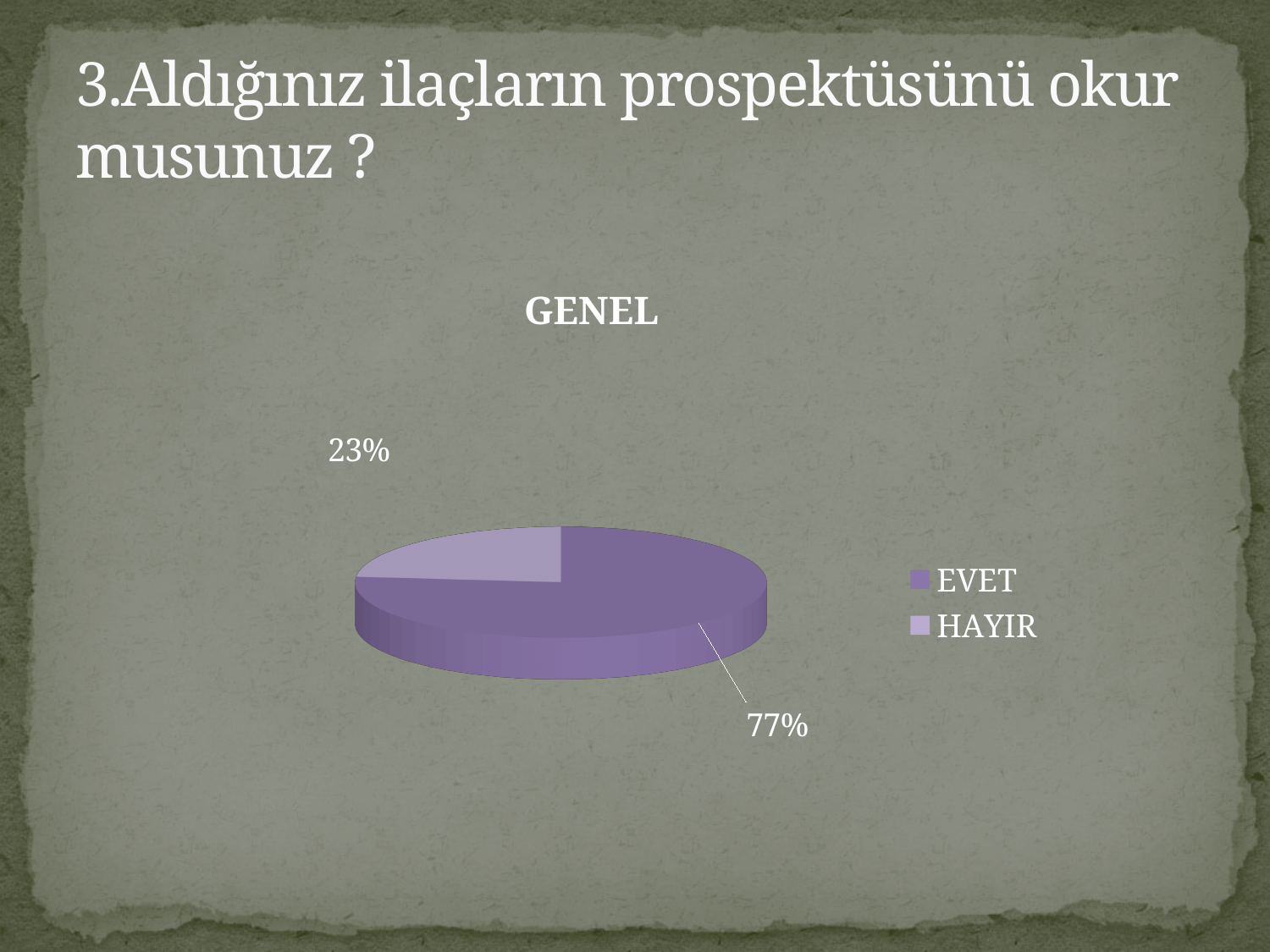
What kind of chart is shown on the slide? pie chart What is the difference in percentage points between the EVET and HAYIR shares? 54 Which category has the largest share of the pie? EVET How many slices does the pie chart have? 2 What is the title of the chart? GENEL How many entries does the legend list? 2 Which is larger, the share for EVET or the share for HAYIR? EVET What percentage of the pie is labelled HAYIR? 23% Which legend entry is shown in the lighter purple colour? HAYIR What share of the pie does the HAYIR slice represent? 23% What percentage of the pie is labelled EVET? 77% Which category has the smallest share of the pie? HAYIR